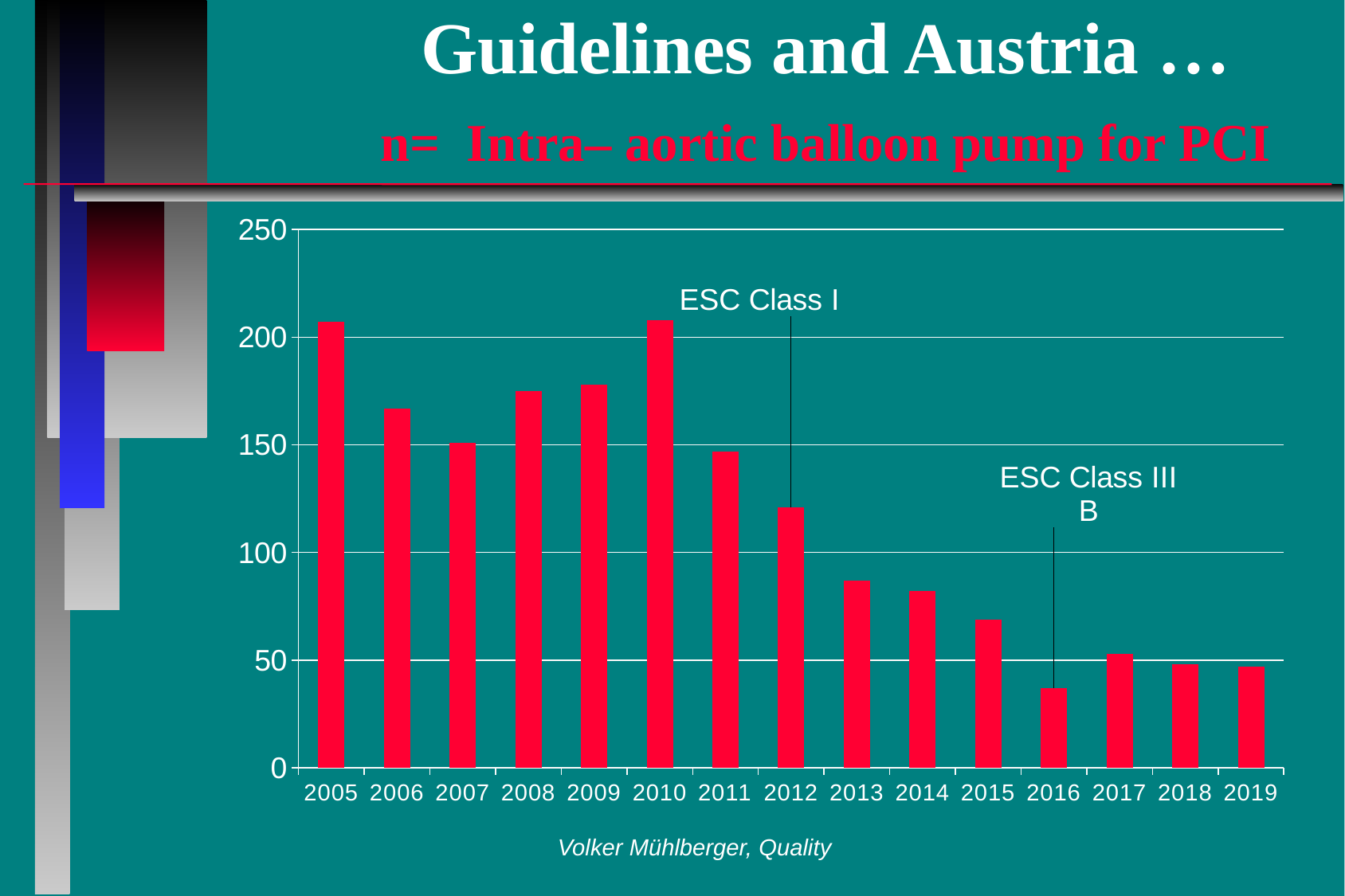
Do the values generally rise or fall from 2005 to 2019? fall Which year is annotated with the label 'ESC Class III B'? 2016 Which year has the larger value, 2006 or 2007? 2006 Which year is annotated with the label 'ESC Class I'? 2012 Is the value for 2009 greater or less than 150? greater Is the value for 2013 greater or less than 100? less How many years are shown on the x axis of the chart? 15 Is the value for 2016 greater or less than 50? less What kind of chart is shown on the slide? bar chart Which year has the lowest value in the chart? 2016